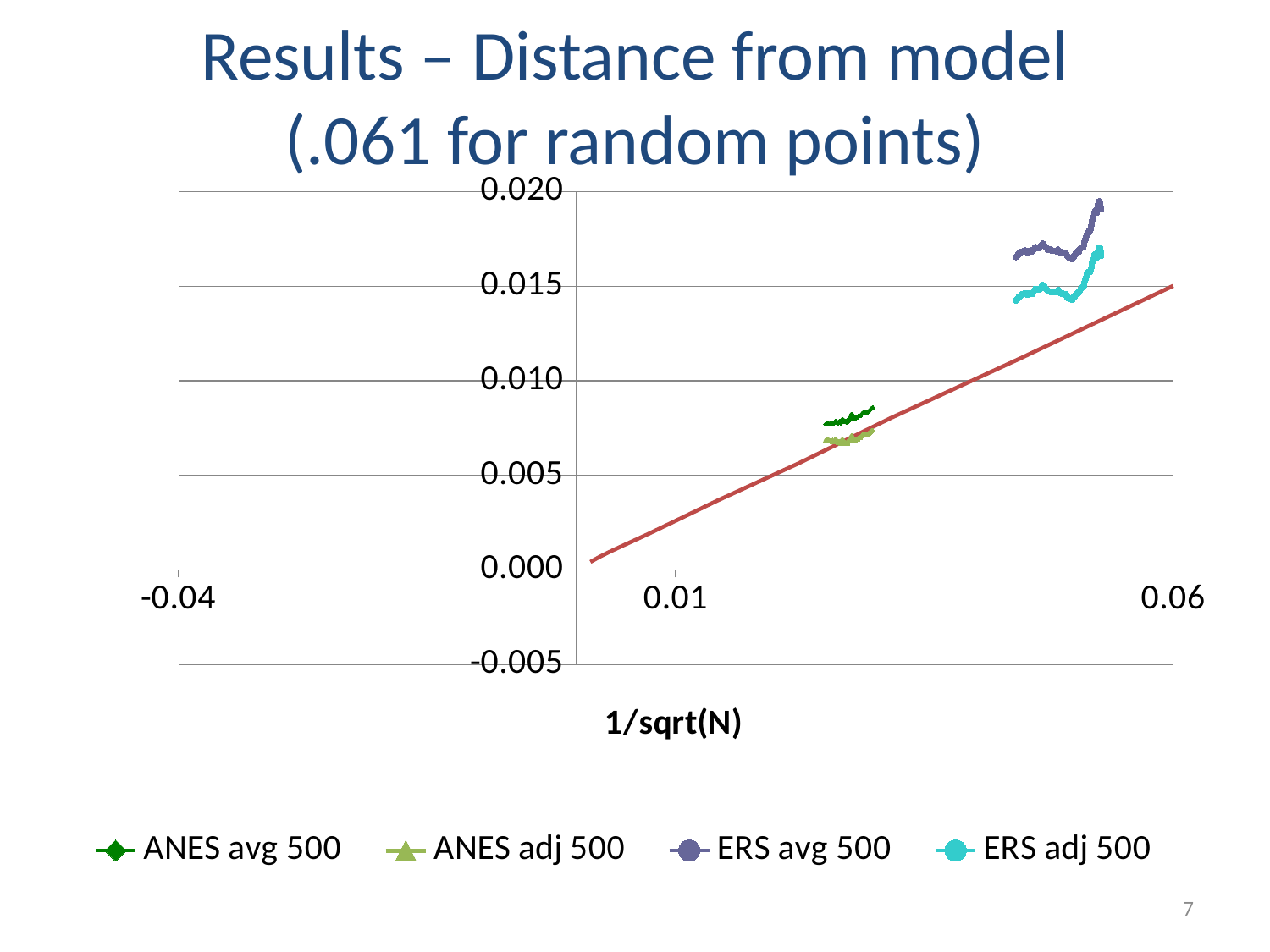
Are the values for ERS avg 500 greater or less than 0.015? greater Which series has larger values, ANES avg 500 or ANES adj 500? ANES avg 500 How many series does the legend list? 4 Are the values for ANES adj 500 greater or less than 0.005? greater Which series has the highest plotted values? ERS avg 500 Are the values for ANES avg 500 greater or less than 0.010? less What is the title of the slide containing the chart? Results – Distance from model (.061 for random points) Which series has the lowest plotted values? ANES adj 500 Which series has larger values, ERS avg 500 or ERS adj 500? ERS avg 500 What kind of chart is shown on the slide? scatter chart Do the plotted values generally rise or fall as 1/sqrt(N) increases along the x axis? rise What is the label of the x axis? 1/sqrt(N)